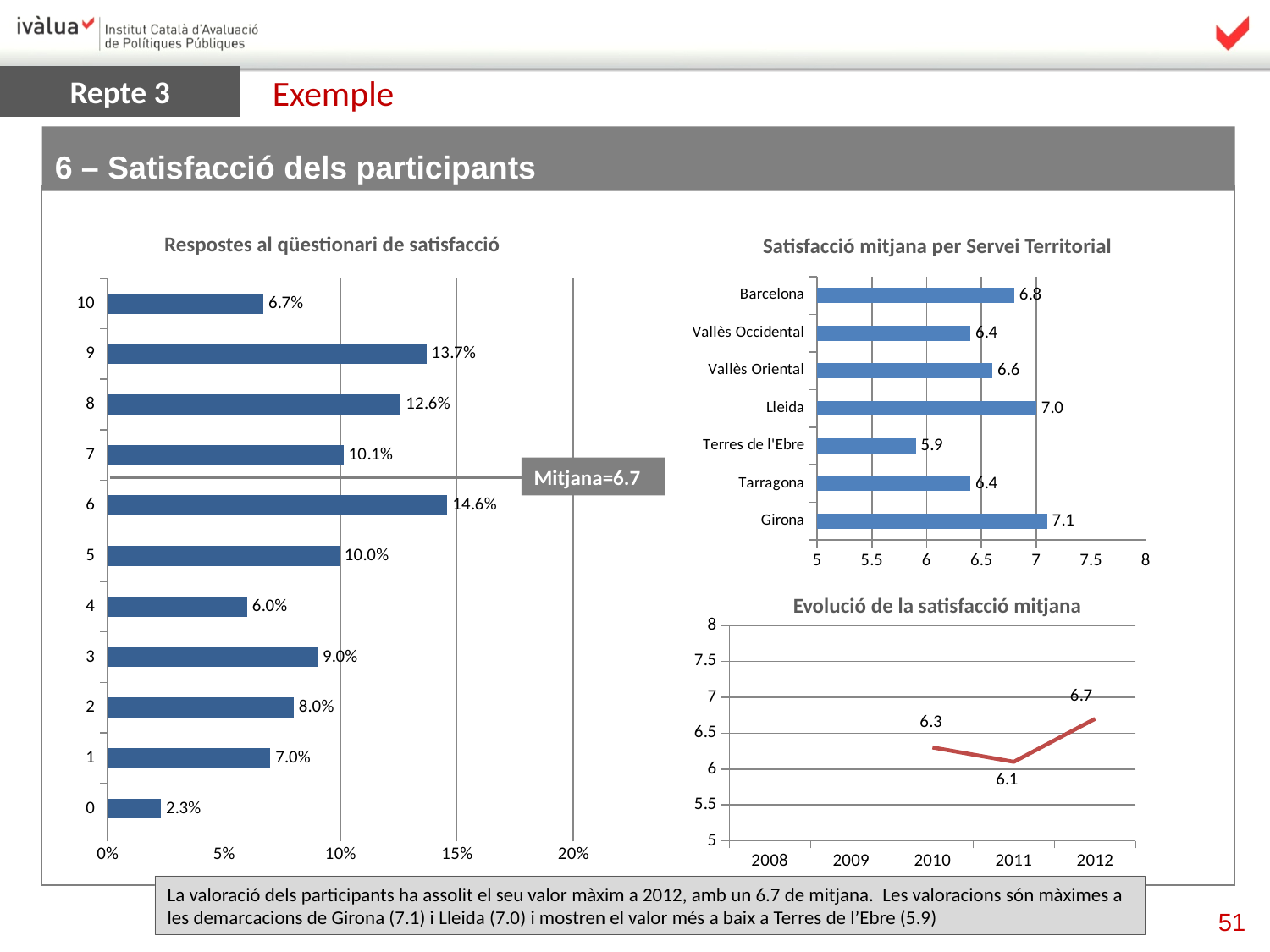
In the chart 'Respostes al qüestionari de satisfacció', what value is indicated by the 'Mitjana' label? 6.7 In the chart 'Satisfacció mitjana per Servei Territorial', how many territorial services are listed? 7 In the chart 'Satisfacció mitjana per Servei Territorial', which has a higher value, Barcelona or Vallès Oriental? Barcelona In the chart 'Satisfacció mitjana per Servei Territorial', what is the average satisfaction for Lleida? 7.0 In the chart 'Evolució de la satisfacció mitjana', what was the average satisfaction in 2011? 6.1 In the chart 'Respostes al qüestionari de satisfacció', which score received the lowest percentage of responses? 0 In the chart 'Satisfacció mitjana per Servei Territorial', which territorial service has the highest average satisfaction? Girona What kind of chart is 'Evolució de la satisfacció mitjana'? Line chart In the chart 'Respostes al qüestionari de satisfacció', how many score categories are shown? 11 In the chart 'Satisfacció mitjana per Servei Territorial', which territorial service has the lowest average satisfaction? Terres de l'Ebre In the chart 'Respostes al qüestionari de satisfacció', what percentage of responses gave a score of 6? 14.6% In the chart 'Respostes al qüestionari de satisfacció', what is the difference between the percentages for scores 9 and 10? 7.0%